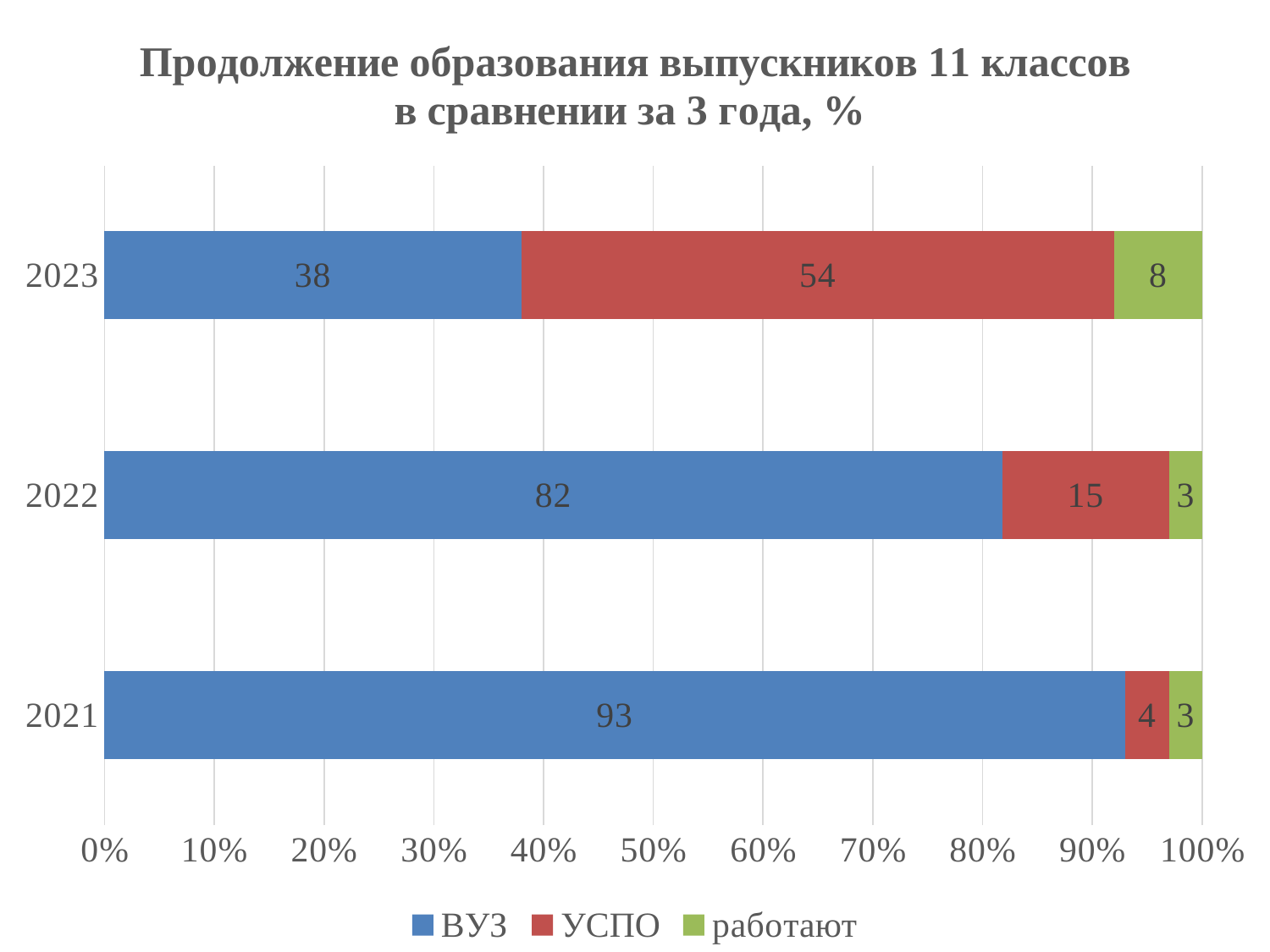
What kind of chart is this? Stacked bar chart What is the total of the stacked bar for 2022? 100 Which is larger in 2023, the ВУЗ value or the УСПО value? УСПО What is the difference between the ВУЗ values for 2021 and 2023? 55 In which year is the ВУЗ value highest? 2021 In which year is the УСПО value lowest? 2021 Which series is shown in green? работают How many years are shown on the chart? 3 What is the value for работают in 2021? 3 What is the value for ВУЗ in 2023? 38 What is the value for УСПО in 2022? 15 How many series does the legend list? 3